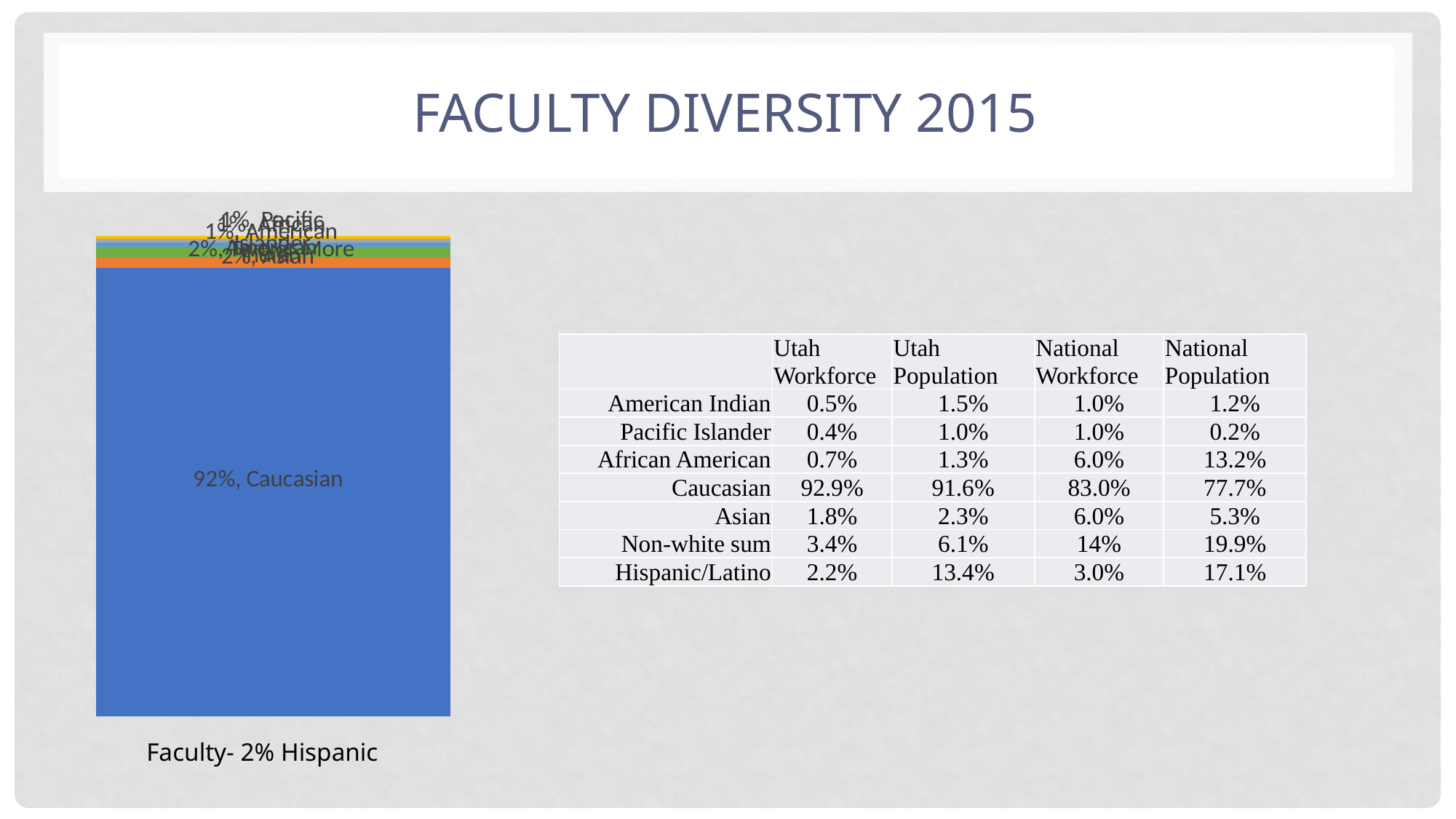
What kind of chart is shown on the left of the slide? bar chart Is the Caucasian segment of the stacked bar larger than all the other segments combined? yes What percentage is labelled for Caucasian in the stacked bar chart? 92% Is the Caucasian segment of the stacked bar greater or less than 50%? greater Which category makes up the largest segment of the stacked bar? Caucasian What colour is the Caucasian segment of the stacked bar? blue